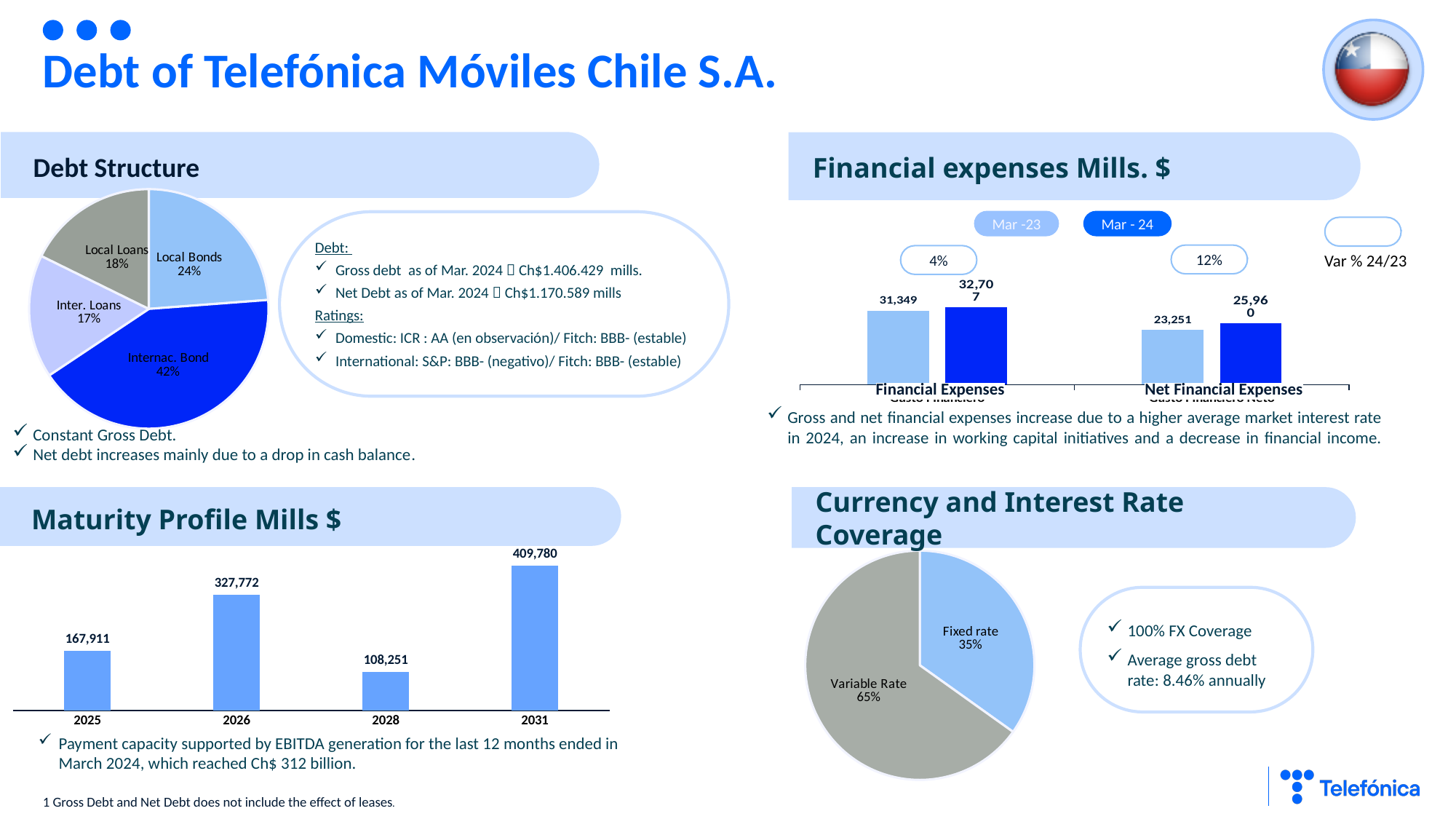
How many slices does the Debt Structure pie chart have? 4 In the Currency and Interest Rate Coverage pie chart, what share is Variable Rate? 65% In the Maturity Profile Mills $ chart, which year has the highest value? 2031 How many series does the legend of the Financial expenses Mills. $ chart list? 2 In the Maturity Profile Mills $ chart, what is the value for 2026? 327,772 In the Debt Structure pie chart, which slice is the smallest? Inter. Loans What kind of chart is the Maturity Profile Mills $ chart? Bar chart In the Maturity Profile Mills $ chart, which year has the lowest value? 2028 In the Financial expenses Mills. $ chart, what is the Mar - 24 value for Financial Expenses? 32,707 In the Financial expenses Mills. $ chart, what is the Mar -23 value for Net Financial Expenses? 23,251 In the Financial expenses Mills. $ chart, what is the difference between the Mar - 24 and Mar -23 values for Net Financial Expenses? 2,709 In the Debt Structure pie chart, what share is Internac. Bond? 42%